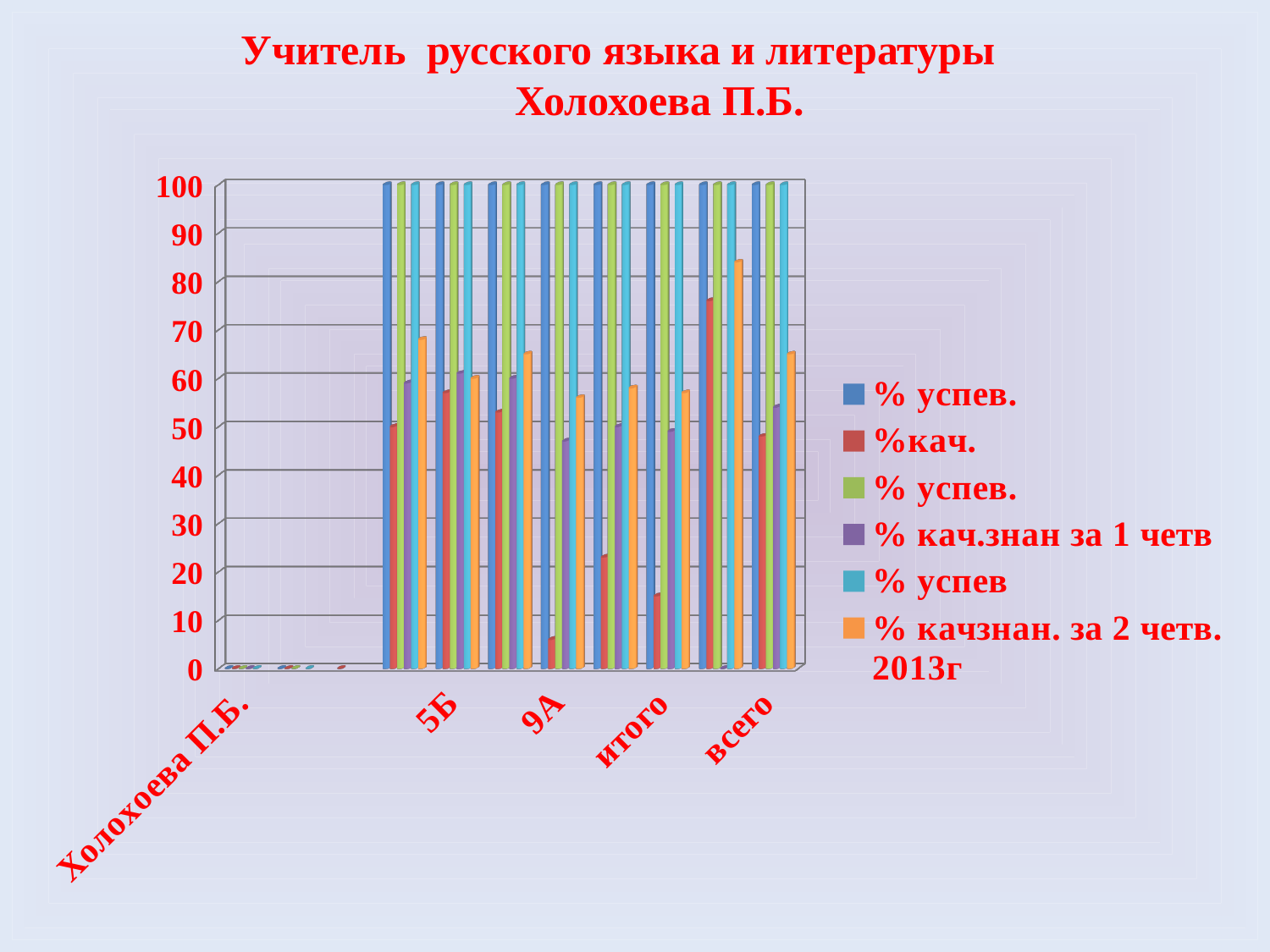
What is the highest value shown on the vertical axis? 100 How many series does the legend list? 6 Is the value for % успев (light blue series) for итого greater or less than 90? greater Is the value for % успев. (blue series) for 5Б greater or less than 90? greater Is the value for % успев. (blue series) for 9А greater or less than 90? greater What kind of chart is shown on the slide? bar chart What is the last entry in the chart legend? % качзнан. за 2 четв. 2013г